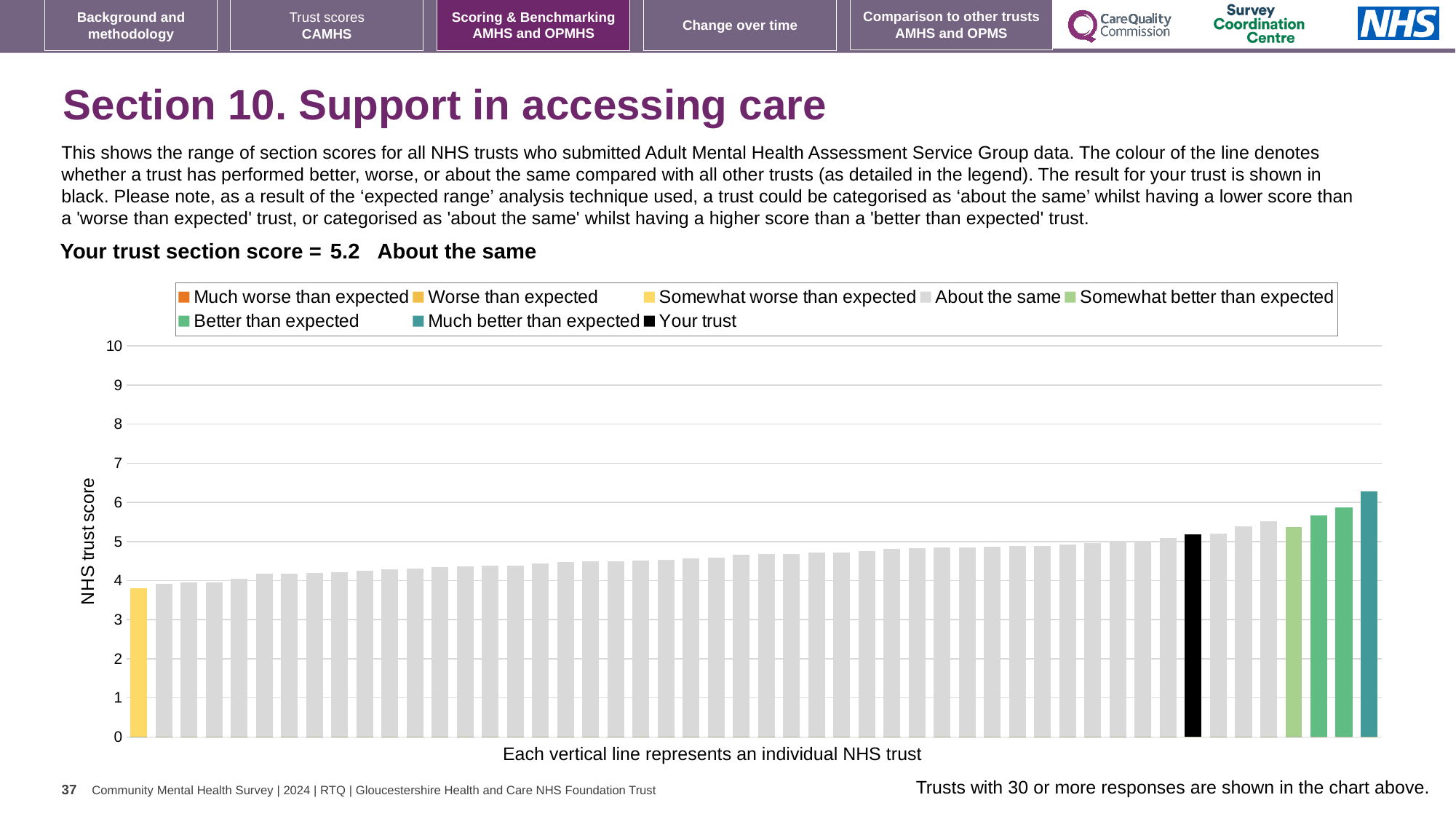
What is the section score for your trust? 5.2 How many entries does the chart legend list? 8 Is the value for your trust (black bar) greater or less than 5? greater Is the value of the tallest bar greater or less than 6? greater Do the bar values rise or fall from left to right across the chart? rise What kind of chart is shown on the slide? bar chart Which is larger: the score for your trust or the score of the yellow 'Worse than expected' bar? your trust Which legend category does the highest-scoring trust belong to? Much better than expected Which legend category does your trust's score fall into? About the same What is the label on the vertical axis of the chart? NHS trust score How many bars are coloured as 'Better than expected' (green)? 2 Which legend category does the lowest-scoring trust belong to? Somewhat worse than expected